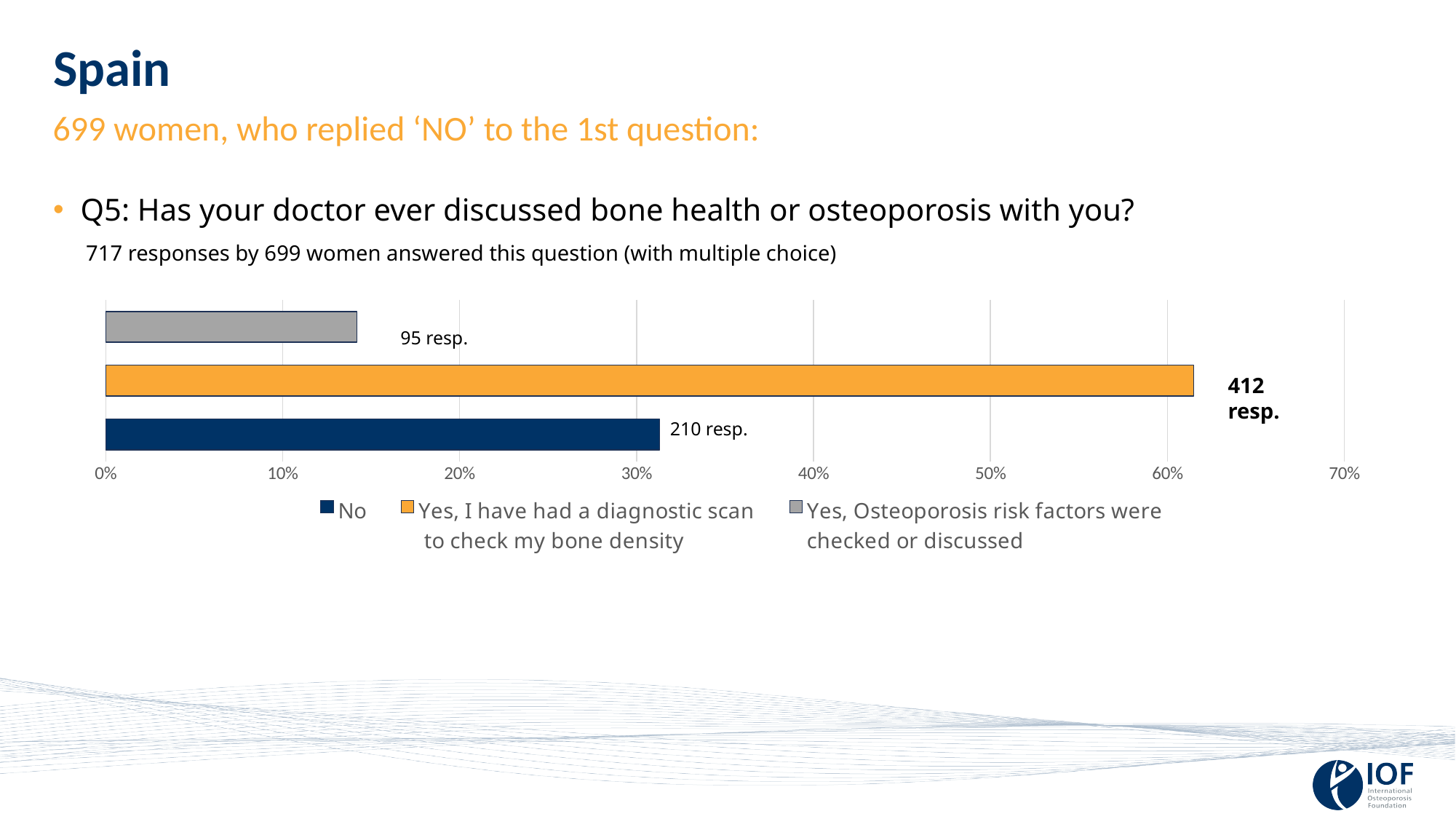
What kind of chart is shown on the slide? Bar chart Is the percentage for 'Yes, Osteoporosis risk factors were checked or discussed' greater or less than 20%? less Which response option has the highest number of responses? Yes, I have had a diagnostic scan to check my bone density How many responses does the 'Yes, I have had a diagnostic scan to check my bone density' bar show? 412 resp. Is the percentage for 'Yes, I have had a diagnostic scan to check my bone density' greater or less than 50%? greater How many series does the legend list? 3 How many responses does the 'No' bar show? 210 resp. What is the difference in responses between 'Yes, I have had a diagnostic scan to check my bone density' and 'No'? 202 How many responses does the 'Yes, Osteoporosis risk factors were checked or discussed' bar show? 95 resp. Which has more responses: 'No' or 'Yes, Osteoporosis risk factors were checked or discussed'? No Which response option has the lowest number of responses? Yes, Osteoporosis risk factors were checked or discussed What is the difference in responses between 'No' and 'Yes, Osteoporosis risk factors were checked or discussed'? 115